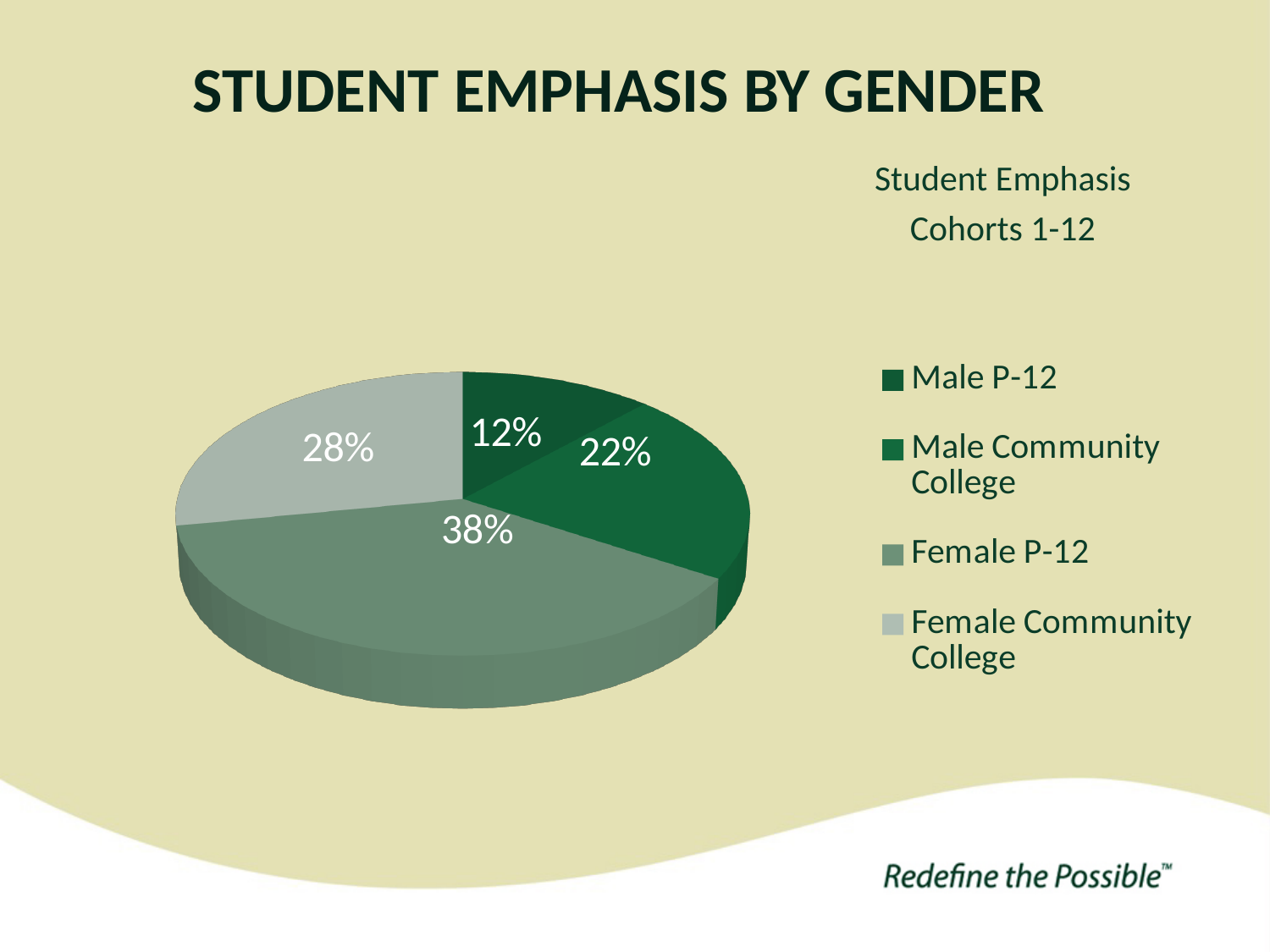
What percentage of the pie is Female P-12? 38% What is the title of the chart? Student Emphasis Cohorts 1-12 What kind of chart is shown on the slide? Pie chart Which is larger, the share for Male Community College or the share for Female Community College? Female Community College Which category has the smallest share of the pie? Male P-12 What is the difference in percentage points between Female P-12 and Male P-12? 26 What percentage of the pie is Male P-12? 12% How many slices does the pie chart have? 4 What percentage of the pie is Female Community College? 28% Which category has the largest share of the pie? Female P-12 What is the combined share of the two Male categories? 34% What percentage of the pie is Male Community College? 22%